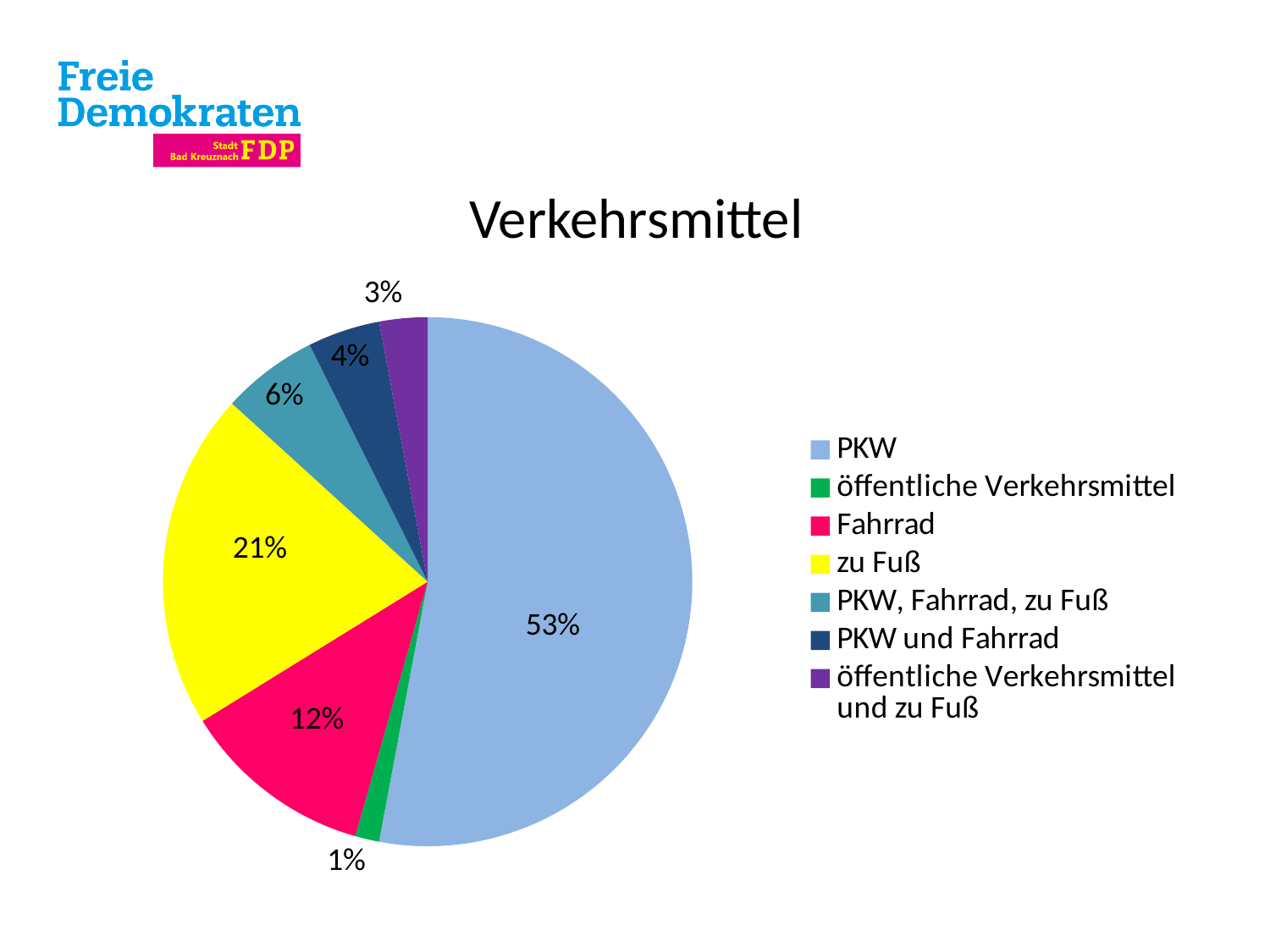
What share of the pie does Fahrrad have? 12% Which category has the smallest share of the pie? öffentliche Verkehrsmittel What share of the pie does PKW und Fahrrad have? 4% Which category has the largest share of the pie? PKW What type of chart is shown on the slide? pie chart What share of the pie does öffentliche Verkehrsmittel have? 1% What is the difference in percentage points between the shares of zu Fuß and Fahrrad? 9 What is the title of the chart? Verkehrsmittel How many categories does the legend list? 7